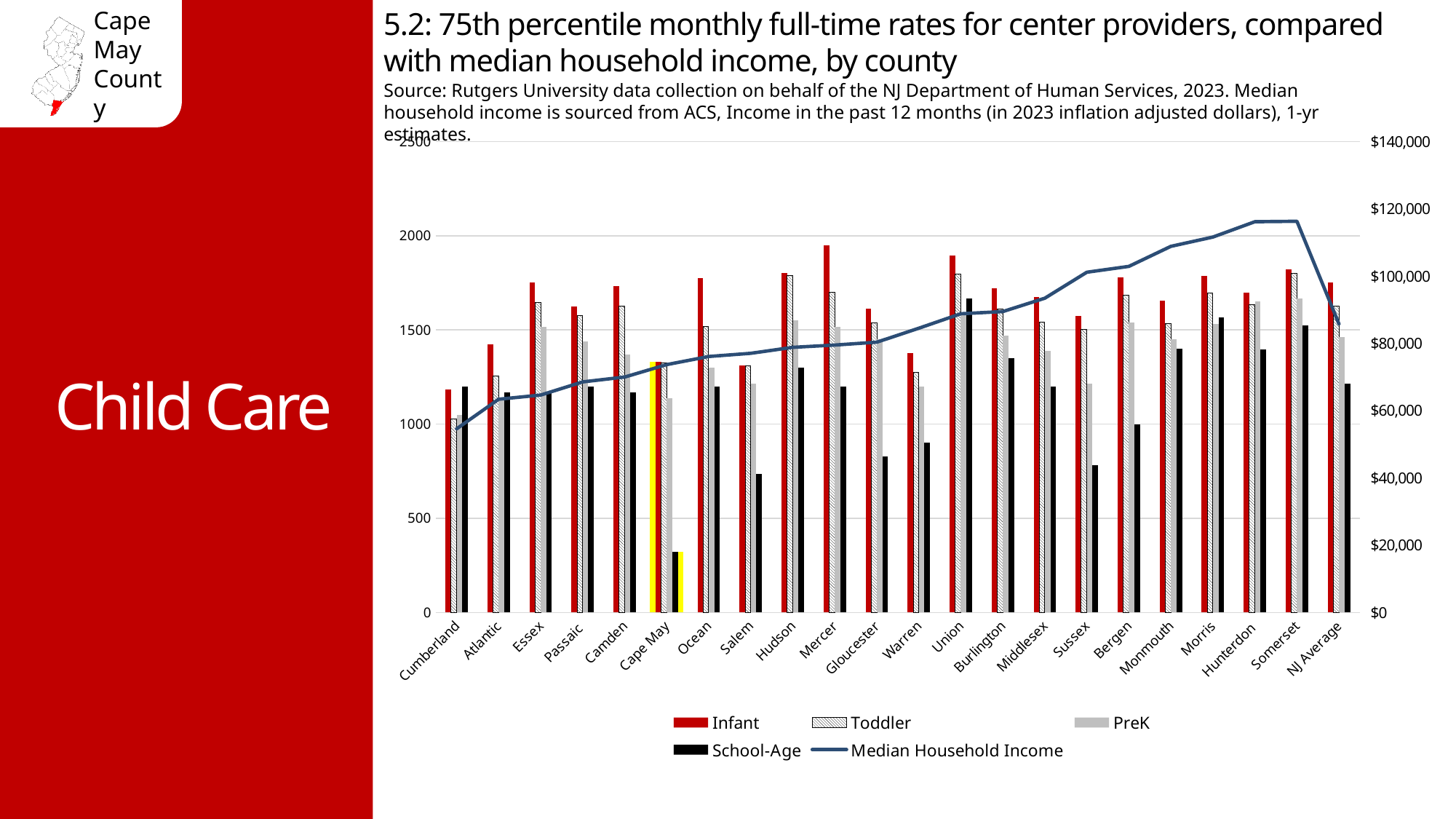
Which is larger, the Infant rate for Mercer or the Infant rate for Cumberland? Mercer Is the School-Age value for Salem greater or less than 1000? less Is the School-Age value for Cape May greater or less than 500? less Which county has the lowest School-Age rate? Cape May What kind of chart is shown on the slide? A bar chart combined with a line chart Does the Median Household Income line generally rise or fall from Cumberland to Somerset? rise Is the Infant value for Mercer greater or less than 1500? greater Which series is plotted as a line rather than bars? Median Household Income How many series does the legend list? 5 Which county has the highest Infant rate? Mercer How many counties (including NJ Average) are shown on the x axis? 22 Which county has the lowest Infant rate? Cumberland